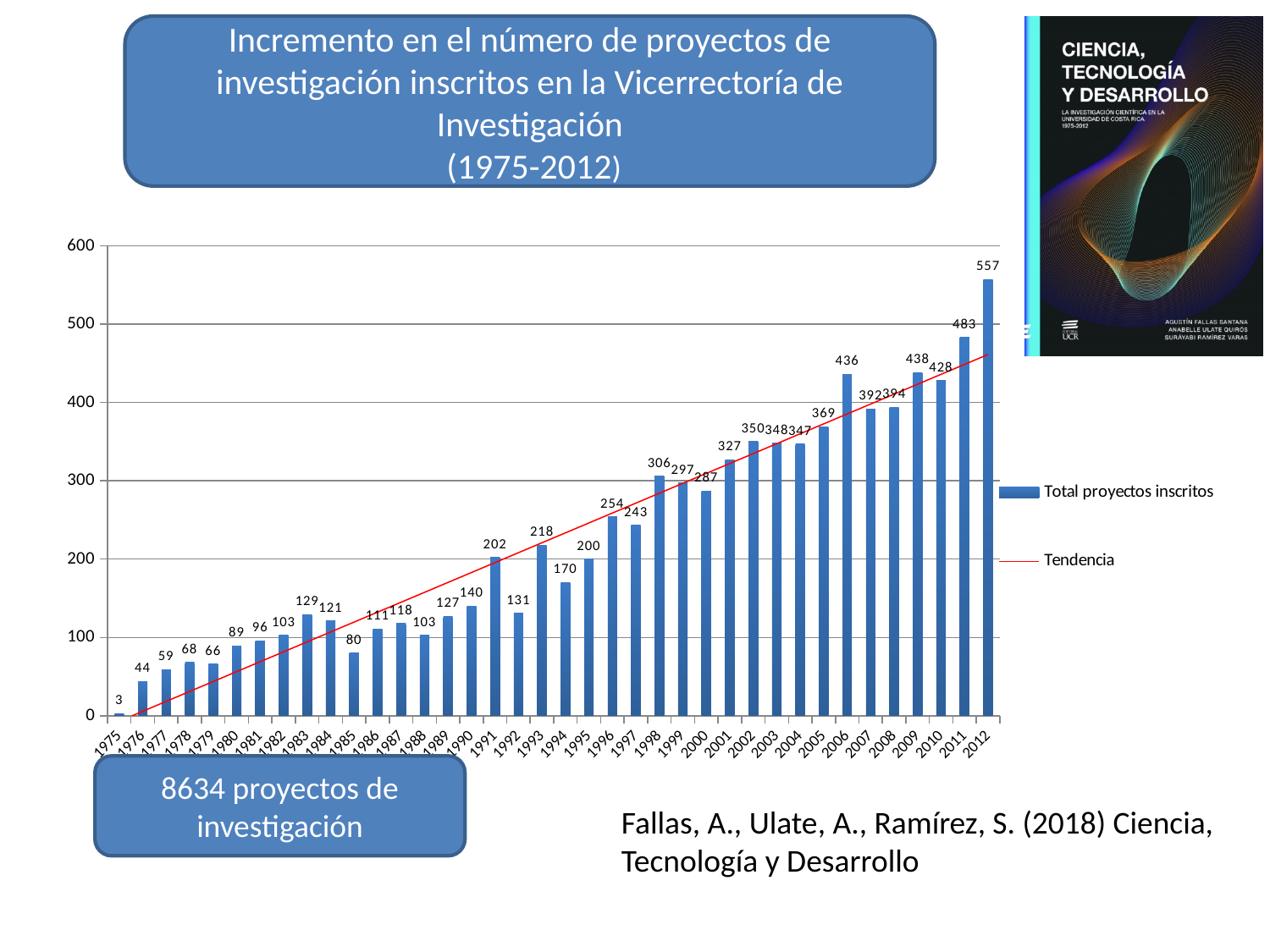
What is the difference between the values for 2012 and 2011? 74 How many years are shown on the x axis? 38 What is the value for 2012? 557 Which year has the lowest value? 1975 Do the values generally rise or fall from 1975 to 2012? Rise How many entries does the legend list? 2 What is the name of the series shown by the red line in the legend? Tendencia What is the value for 1985? 80 What is the value for 1991? 202 Which is larger, the value for 2006 or the value for 2007? 2006 Which year has the highest value? 2012 What kind of chart is this? Bar chart